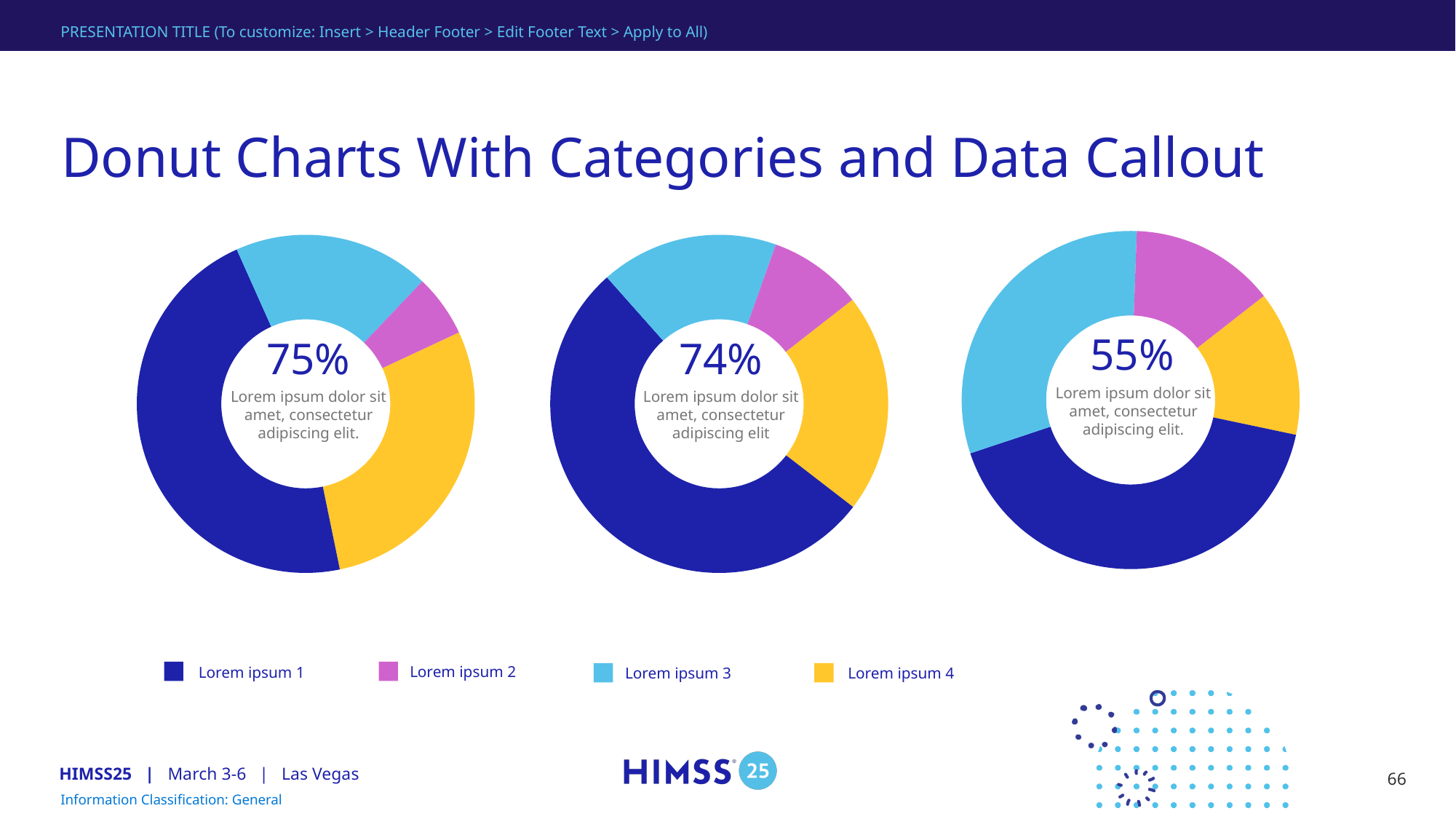
How many slices does the middle donut chart have? 4 In the middle donut chart, which category has the smallest slice? Lorem ipsum 2 Which is larger, the centre percentage of the left donut chart or the centre percentage of the right donut chart? Left donut chart What kind of chart is shown on the left of the slide? Donut chart Which colour represents Lorem ipsum 4 in the legend? Yellow In the left donut chart, which category has the largest slice? Lorem ipsum 1 What percentage is shown in the centre of the middle donut chart? 74% What percentage is shown in the centre of the left donut chart? 75% In the right donut chart, which category has the largest slice? Lorem ipsum 1 In the left donut chart, which category has the smallest slice? Lorem ipsum 2 What percentage is shown in the centre of the right donut chart? 55% How many series does the legend list? 4